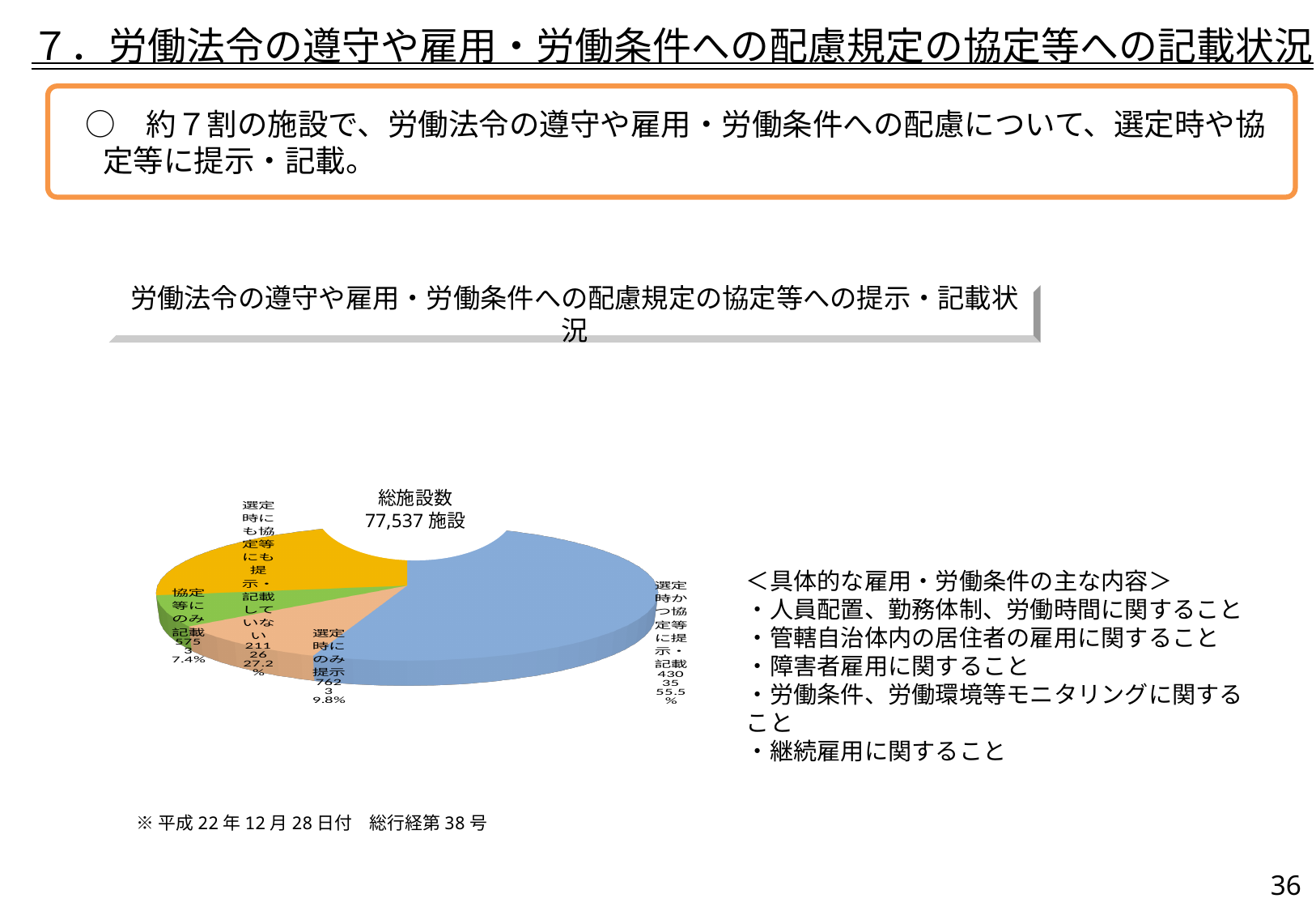
What is the difference in percentage points between the share for 選定時かつ協定等に提示・記載 and the share for 選定時にも協定等にも提示・記載していない? 28.3 What is the total number of facilities (総施設数) shown on the chart? 77,537 施設 What kind of chart is shown on the slide? Pie chart What percentage share is shown for 協定等にのみ記載? 7.4% Which has the larger share: 選定時にのみ提示 or 協定等にのみ記載? 選定時にのみ提示 What percentage share is shown for 選定時にのみ提示? 9.8% What percentage share is shown for 選定時にも協定等にも提示・記載していない? 27.2% What colour is the largest slice of the pie chart? Blue How many slices does the pie chart have? 4 Which category has the largest share of the pie chart? 選定時かつ協定等に提示・記載 Which category has the smallest share of the pie chart? 協定等にのみ記載